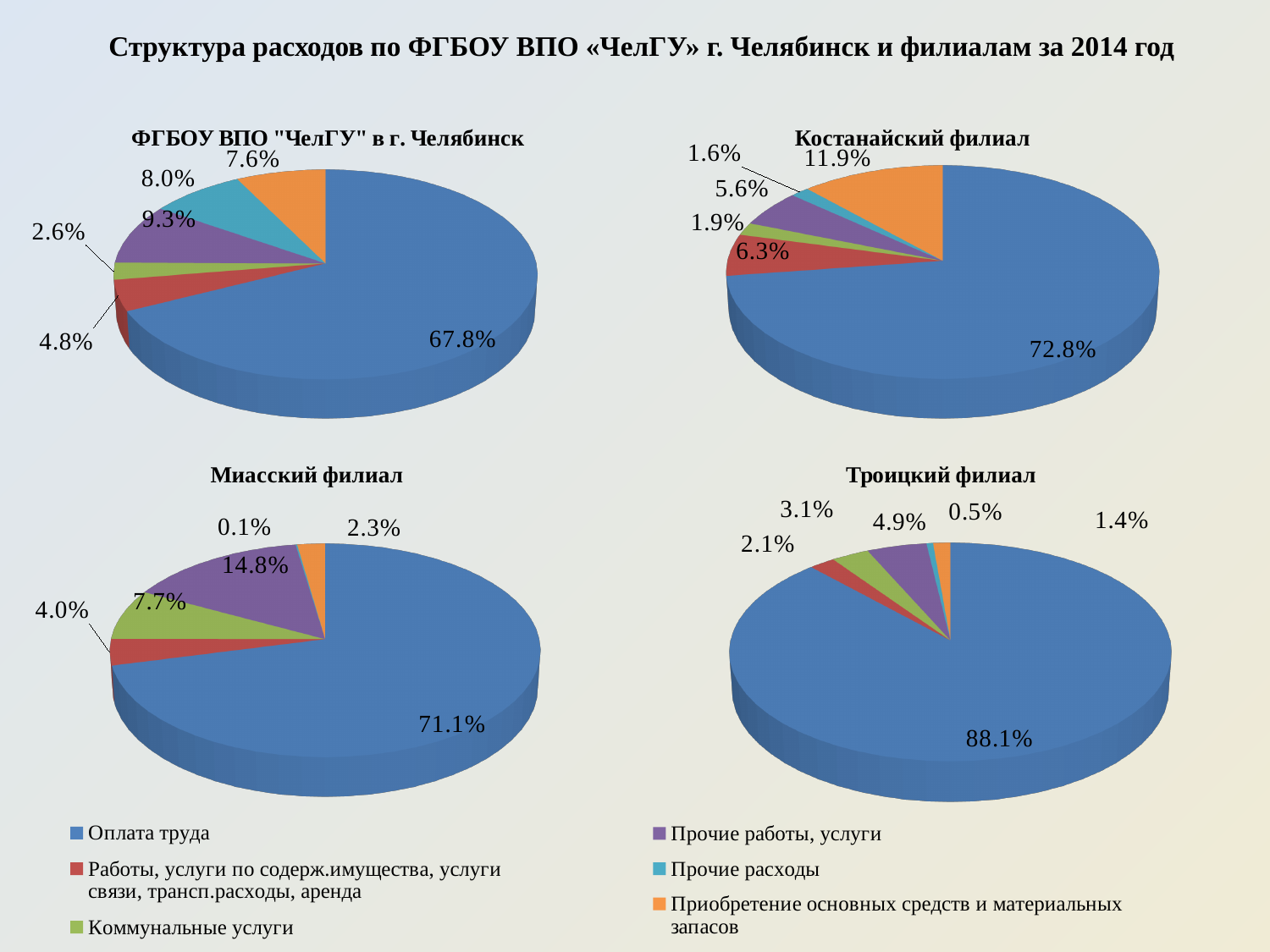
In the chart titled "Миасский филиал", what share is shown for Оплата труда? 71.1% In the chart titled "Костанайский филиал", what share is shown for Оплата труда? 72.8% Which chart shows a larger share for Оплата труда: "Костанайский филиал" or "Миасский филиал"? Костанайский филиал In the chart titled "ФГБОУ ВПО "ЧелГУ" в г. Челябинск", what share is shown for Оплата труда? 67.8% In the chart titled "Троицкий филиал", which category has the largest share? Оплата труда How many charts are shown on the slide? 4 How many categories does the legend list? 6 What is the difference between the Оплата труда share in the "Троицкий филиал" chart and the Оплата труда share in the "ФГБОУ ВПО "ЧелГУ" в г. Челябинск" chart? 20.3% In the chart titled "Костанайский филиал", what share is shown for Приобретение основных средств и материальных запасов? 11.9% In the chart titled "Троицкий филиал", what share is shown for Оплата труда? 88.1% What type of chart is used on this slide? Pie chart In the chart titled "Миасский филиал", what share is shown for Прочие работы, услуги? 14.8%